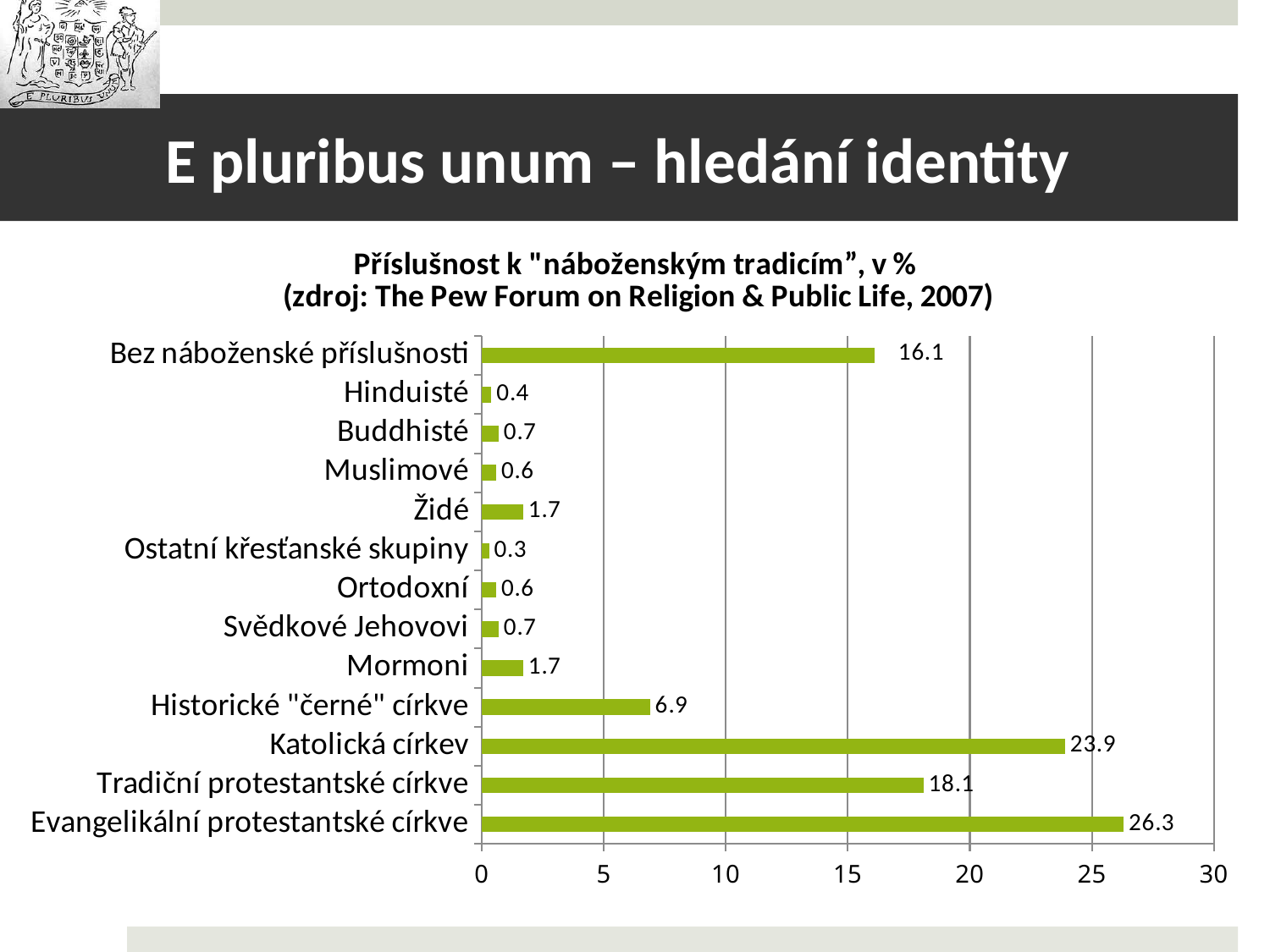
What is the source cited in the chart title? The Pew Forum on Religion & Public Life, 2007 Which category has the highest value? Evangelikální protestantské církve How many categories are shown in the chart? 13 What is the value for Historické "černé" církve? 6.9 What is the difference between Evangelikální protestantské církve and Tradiční protestantské církve? 8.2 What kind of chart is shown on the slide? bar chart What is the value for Katolická církev? 23.9 Which is larger, the value for Židé or the value for Muslimové? Židé What is the difference between Katolická církev and Bez náboženské příslušnosti? 7.8 What is the value for Bez náboženské příslušnosti? 16.1 Is the value for Tradiční protestantské církve greater or less than 15? greater Which category has the lowest value? Ostatní křesťanské skupiny